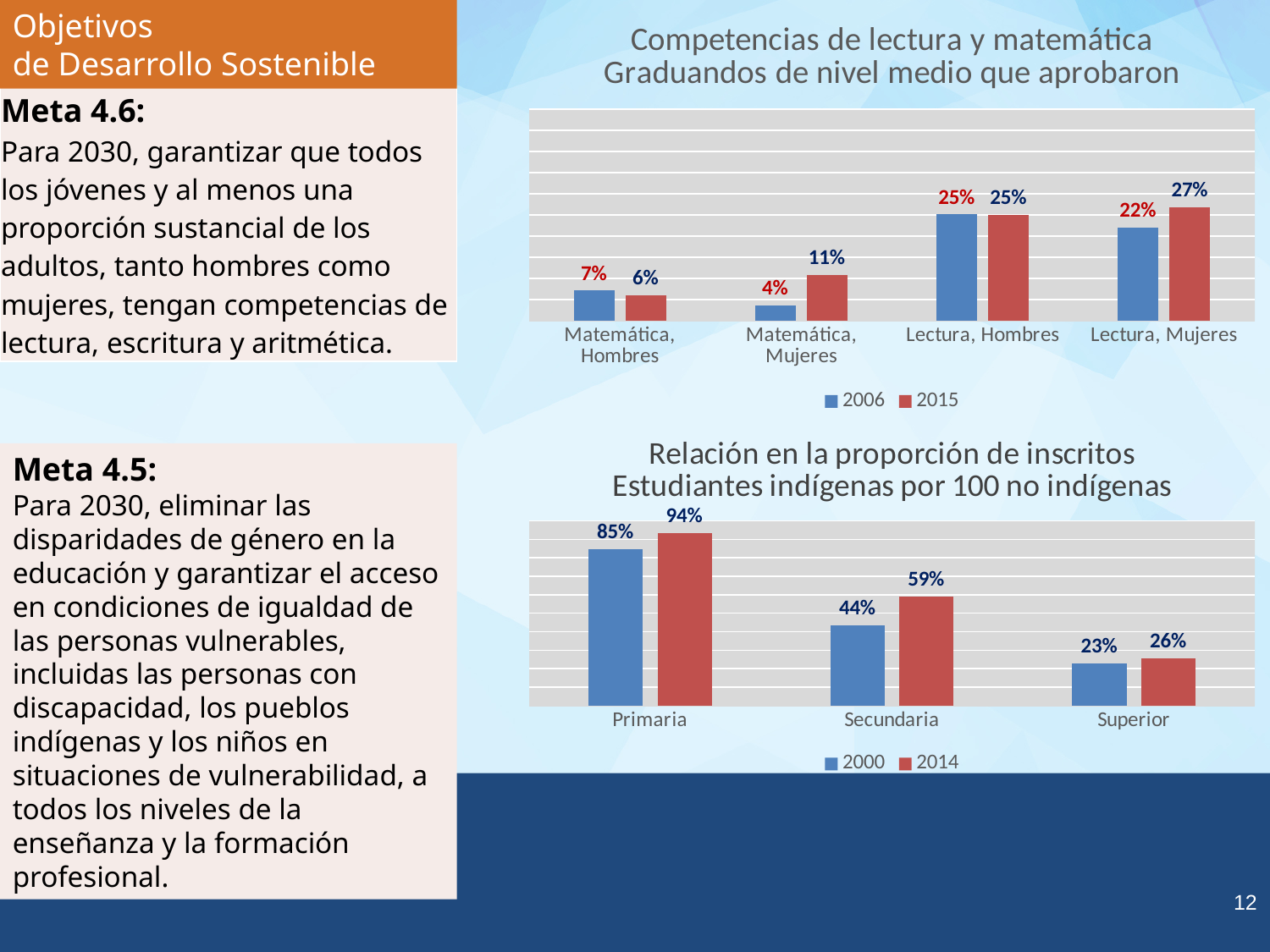
In the top chart (Competencias de lectura y matemática), which category has the highest 2015 value? Lectura, Mujeres In the bottom chart (Relación en la proporción de inscritos), what is the 2014 value for Secundaria? 59% In the bottom chart (Relación en la proporción de inscritos), which category has the highest 2000 value? Primaria In the bottom chart (Relación en la proporción de inscritos), is the 2000 value for Superior larger or smaller than the 2014 value for Superior? smaller What kind of chart is the bottom chart (Relación en la proporción de inscritos)? bar chart In the bottom chart (Relación en la proporción de inscritos), what is the difference between the 2014 and 2000 values for Primaria? 9% In the top chart (Competencias de lectura y matemática), how many series does the legend list? 2 In the top chart (Competencias de lectura y matemática), which category has the lowest 2006 value? Matemática, Mujeres In the top chart (Competencias de lectura y matemática), how many categories are shown on the x axis? 4 In the top chart (Competencias de lectura y matemática), what is the 2015 value for Matemática, Mujeres? 11% In the top chart (Competencias de lectura y matemática), what is the difference between the 2015 and 2006 values for Matemática, Mujeres? 7% In the top chart (Competencias de lectura y matemática), what is the 2006 value for Lectura, Mujeres? 22%